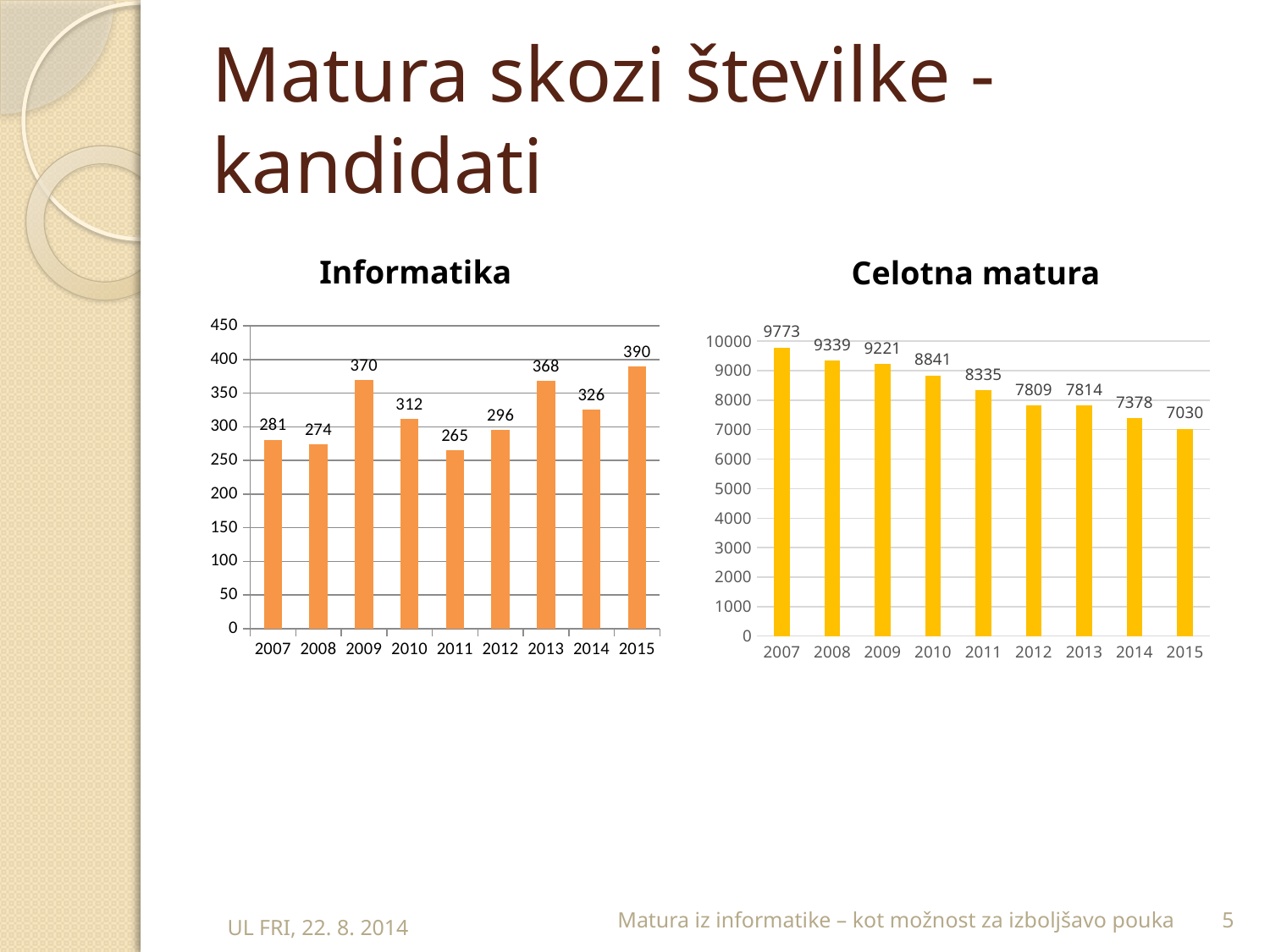
What kind of chart is the 'Informatika' chart? bar chart In the 'Celotna matura' chart, do the values generally rise or fall from 2007 to 2015? fall In the 'Celotna matura' chart, what is the difference between the values for 2007 and 2015? 2743 In the 'Informatika' chart, which year has the lowest value? 2011 In the 'Celotna matura' chart, what is the value for 2011? 8335 In the 'Celotna matura' chart, is the value for 2010 greater or less than 9000? less In the 'Informatika' chart, what is the difference between the values for 2015 and 2011? 125 In the 'Informatika' chart, which year has the highest value? 2015 How many years are shown in the 'Celotna matura' chart? 9 In the 'Informatika' chart, what is the value for 2009? 370 In the 'Celotna matura' chart, which year has the lowest value? 2015 In the 'Informatika' chart, which is larger, the value for 2010 or the value for 2014? 2014